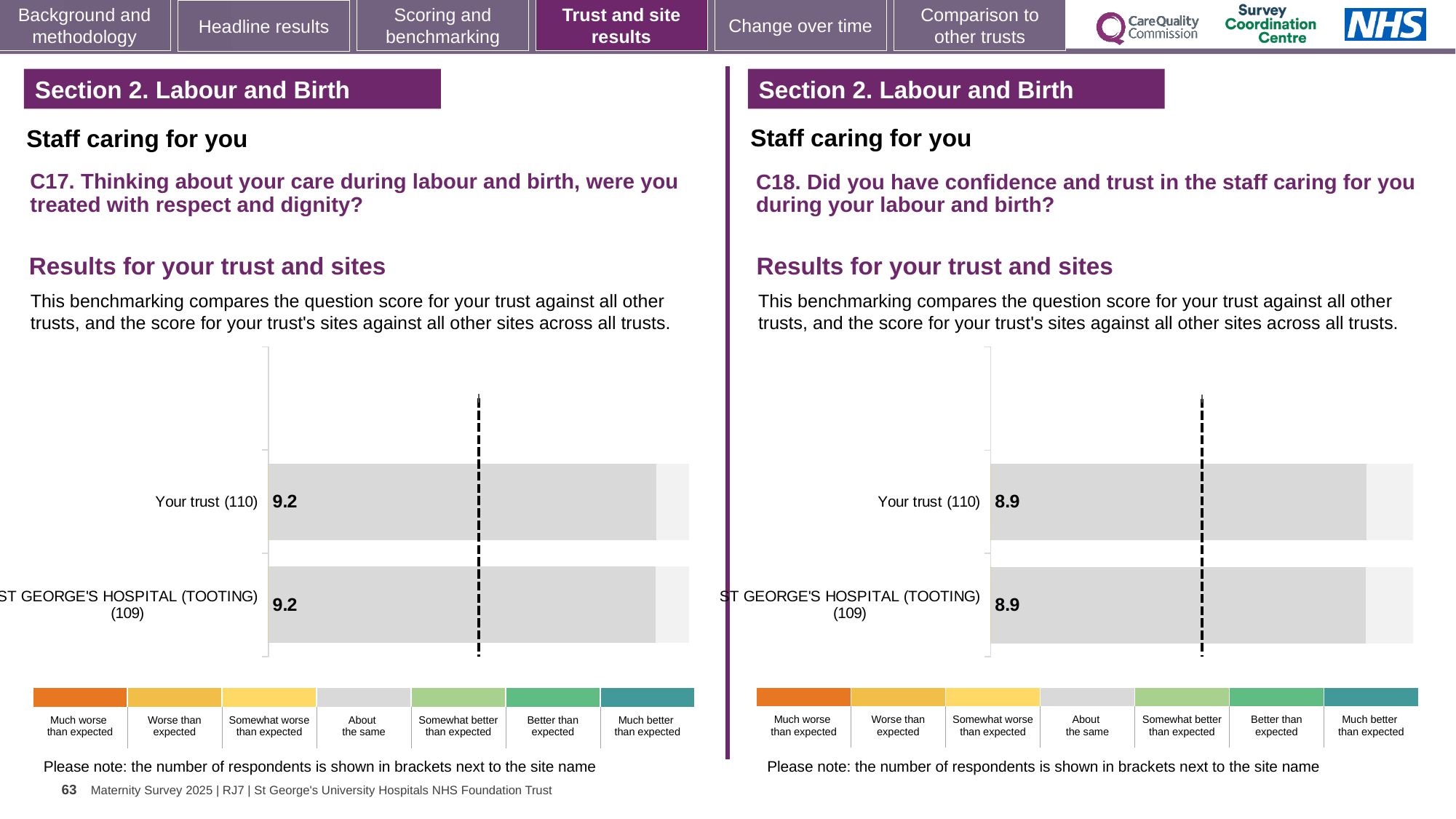
On the left chart (C17), how many respondents are shown in brackets for Your trust? 110 On the left chart (C17), what is the difference between the Your trust score and the St George's Hospital (Tooting) score? 0 How many bars are plotted on the right chart (C18)? 2 On the left chart (C17), what is the score for St George's Hospital (Tooting)? 9.2 On the right chart (C18, confidence and trust in staff), what is the score for Your trust? 8.9 What type of chart is used on the left side of the slide for C17? Bar chart How many bars are plotted on the left chart (C17)? 2 Is the Your trust score on the right chart (C18) higher or lower than the Your trust score on the left chart (C17)? Lower On the right chart (C18), what is the score for St George's Hospital (Tooting)? 8.9 On the right chart (C18), how many respondents are shown in brackets for St George's Hospital (Tooting)? 109 On the left chart (C17, treated with respect and dignity), what is the score for Your trust? 9.2 On the right chart (C18), what is the difference between the Your trust score and the St George's Hospital (Tooting) score? 0